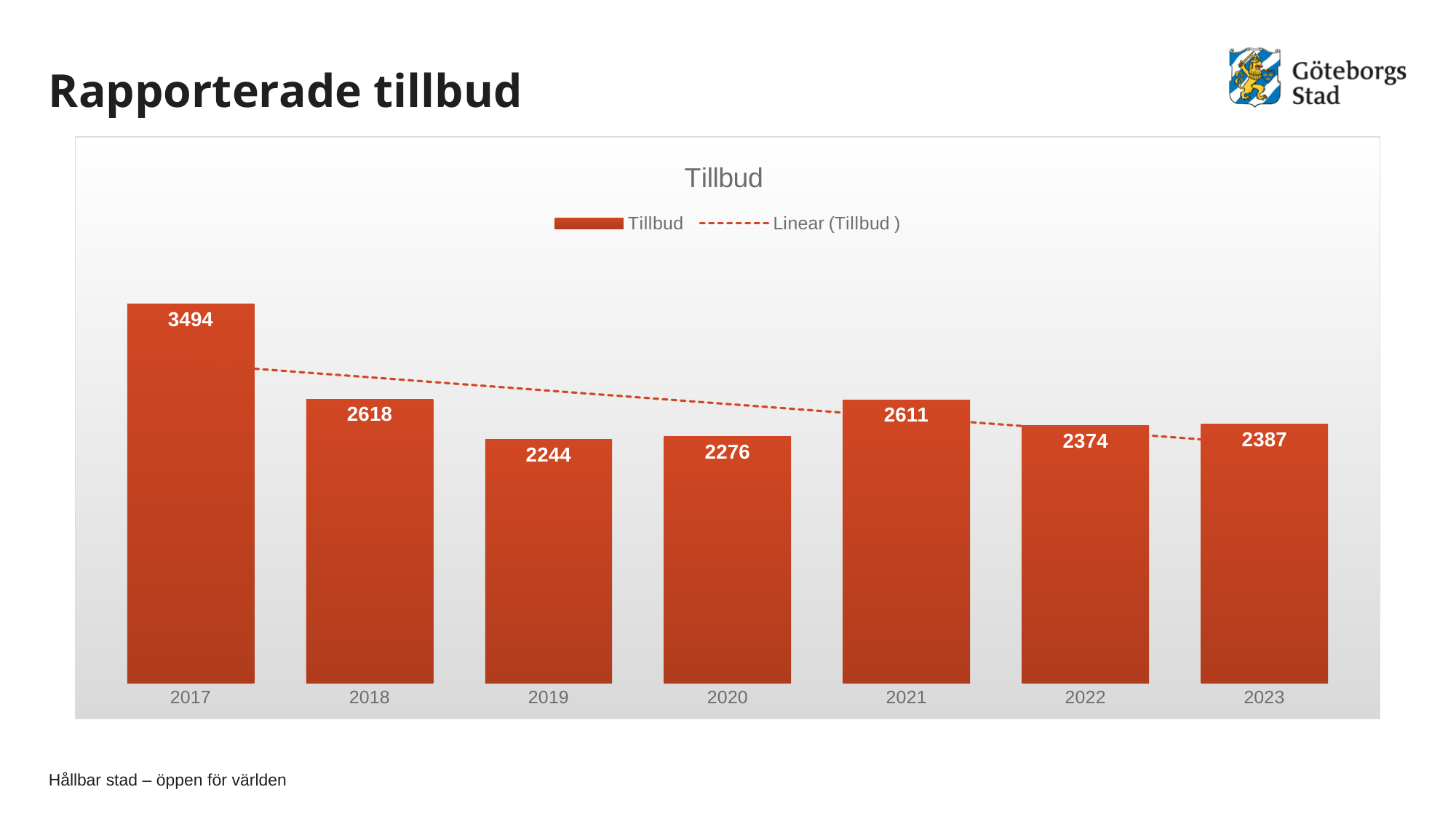
What is the difference between the values for 2023 and 2022? 13 Which is larger, the value for 2018 or the value for 2021? 2018 What is the difference between the values for 2017 and 2018? 876 What is the title of the chart? Tillbud Which year has the lowest value? 2019 Which year has the highest value? 2017 What is the value for 2023? 2387 How many entries does the legend list? 2 What is the value for 2017? 3494 What kind of chart is shown? bar chart How many years are shown on the x axis? 7 What is the value for 2021? 2611